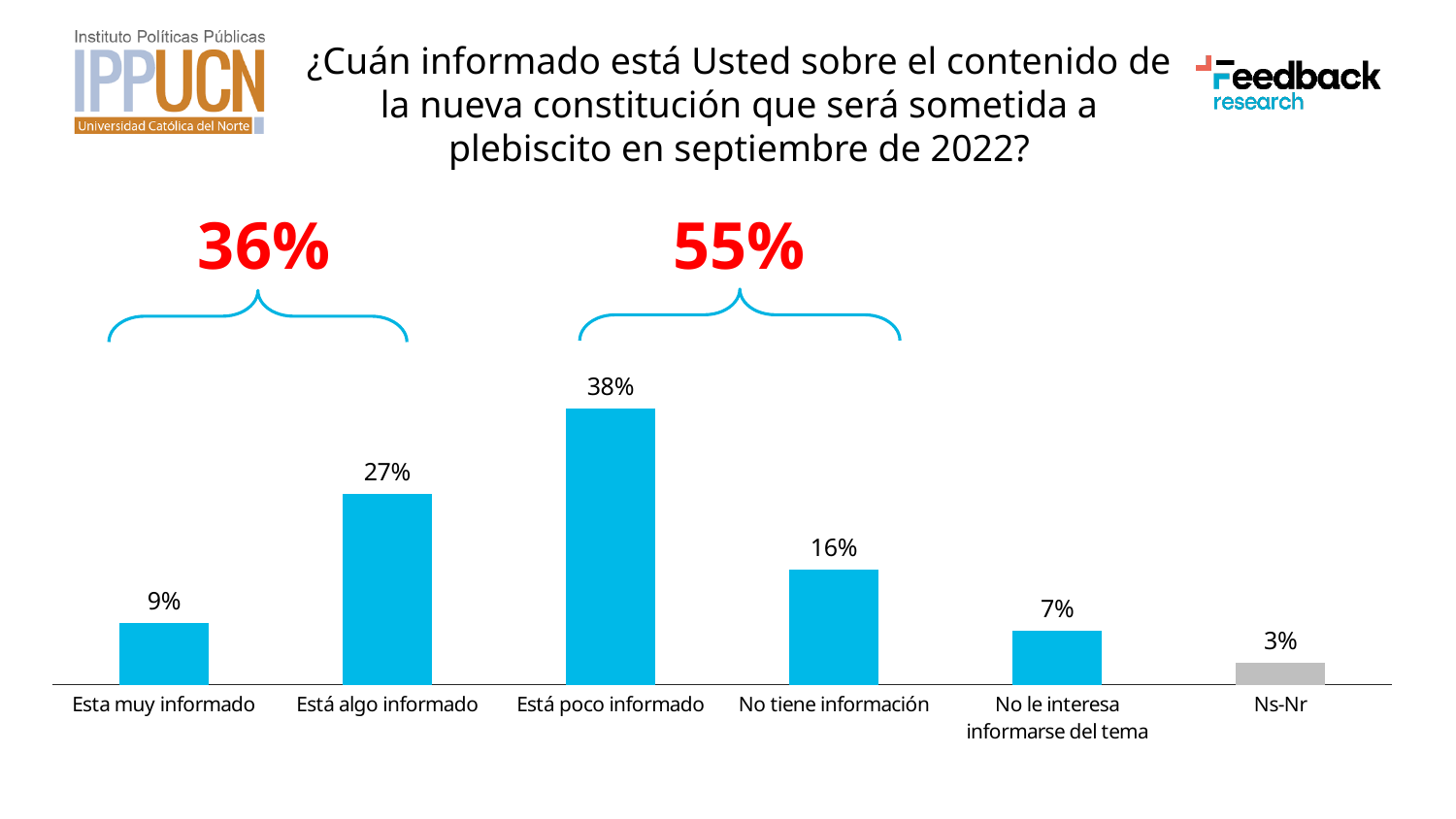
What is the difference between "Está algo informado" and "No tiene información"? 11% What is the combined percentage shown above the bracket covering "Esta muy informado" and "Está algo informado"? 36% Which category has the highest value? Está poco informado What is the value for "No le interesa informarse del tema"? 7% How many categories are shown on the x axis? 6 What is the value for "Esta muy informado"? 9% What kind of chart is shown on the slide? Bar chart What is the value for "Está poco informado"? 38% What is the combined percentage shown above the bracket covering "Está poco informado" and "No tiene información"? 55% Which category has the lowest value? Ns-Nr What is the value for "Ns-Nr"? 3% Which is larger, "Está algo informado" or "No tiene información"? Está algo informado